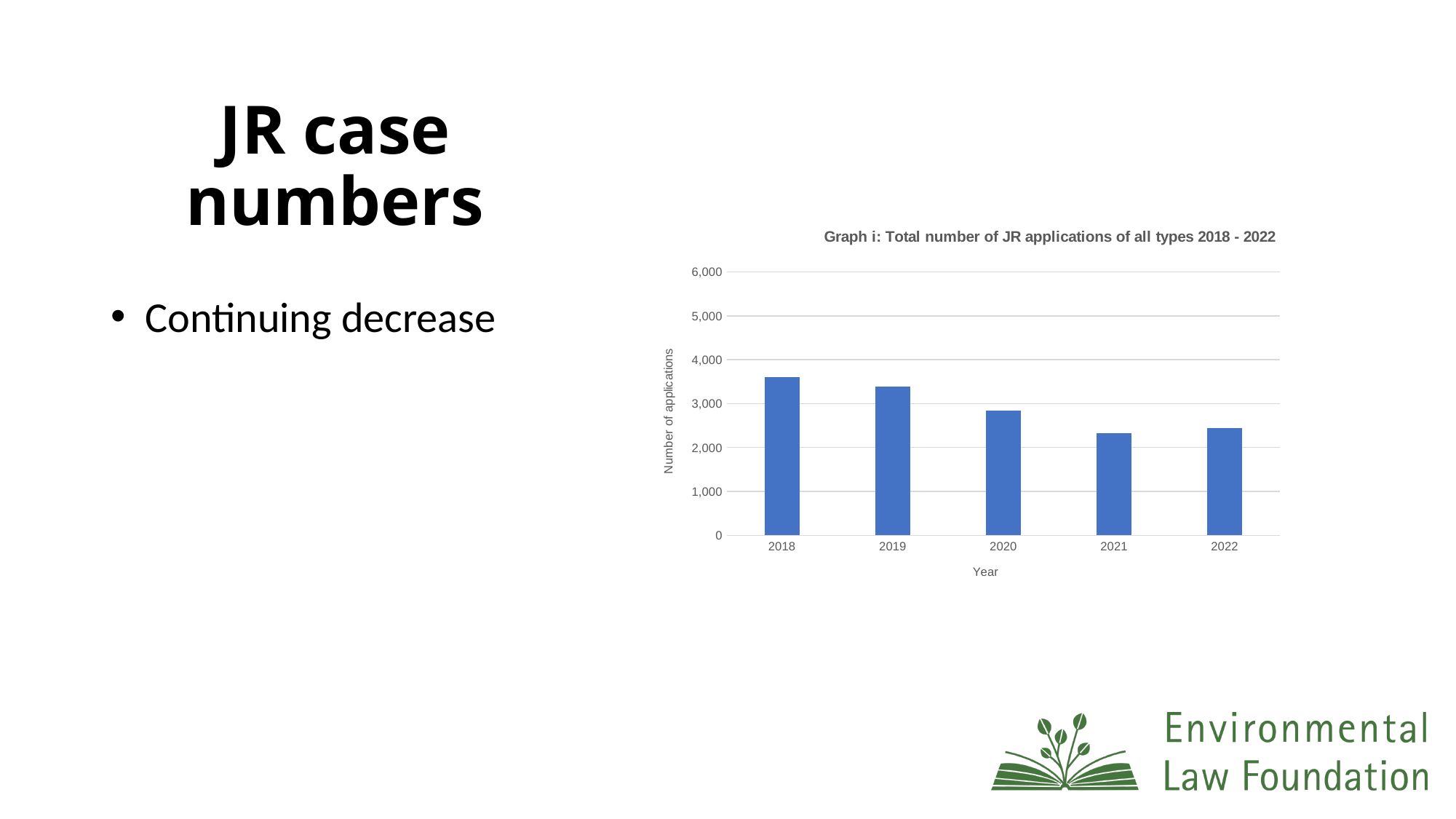
What type of chart is shown on the slide? bar chart Which is larger, the value for 2018 or the value for 2019? 2018 Is the value for 2021 greater or less than 2,000? greater How many years are plotted on the chart? 5 Which year has the highest number of JR applications? 2018 Is the value for 2019 greater or less than 4,000? less What is the title of the chart? Graph i: Total number of JR applications of all types 2018 - 2022 What is the label on the y axis of the chart? Number of applications Is the value for 2022 greater or less than 3,000? less Which is larger, the value for 2020 or the value for 2022? 2020